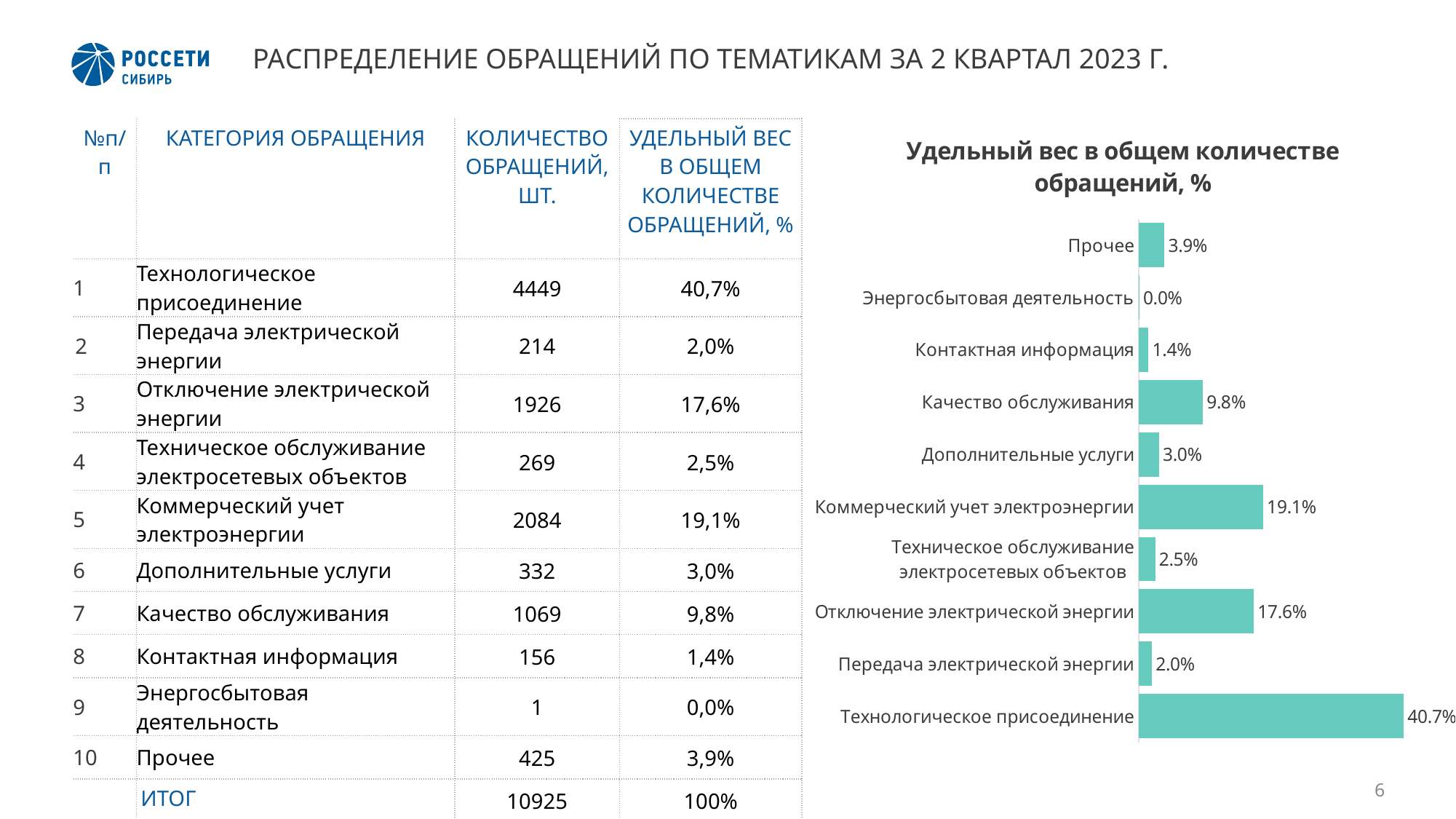
What is the value for Качество обслуживания in the chart? 9.8% What is the value for Контактная информация in the chart? 1.4% What is the difference between the values for Коммерческий учет электроэнергии and Отключение электрической энергии? 1.5% How many categories are plotted in the chart? 10 Which is larger in the chart: Прочее or Дополнительные услуги? Прочее What is the difference between the values for Технологическое присоединение and Качество обслуживания? 30.9% What is the value for Коммерческий учет электроэнергии in the chart? 19.1% What is the title of the chart? Удельный вес в общем количестве обращений, % What is the value for Технологическое присоединение in the chart? 40.7% Which category has the highest value in the chart? Технологическое присоединение Which category has the lowest value in the chart? Энергосбытовая деятельность What type of chart is shown on the slide? bar chart